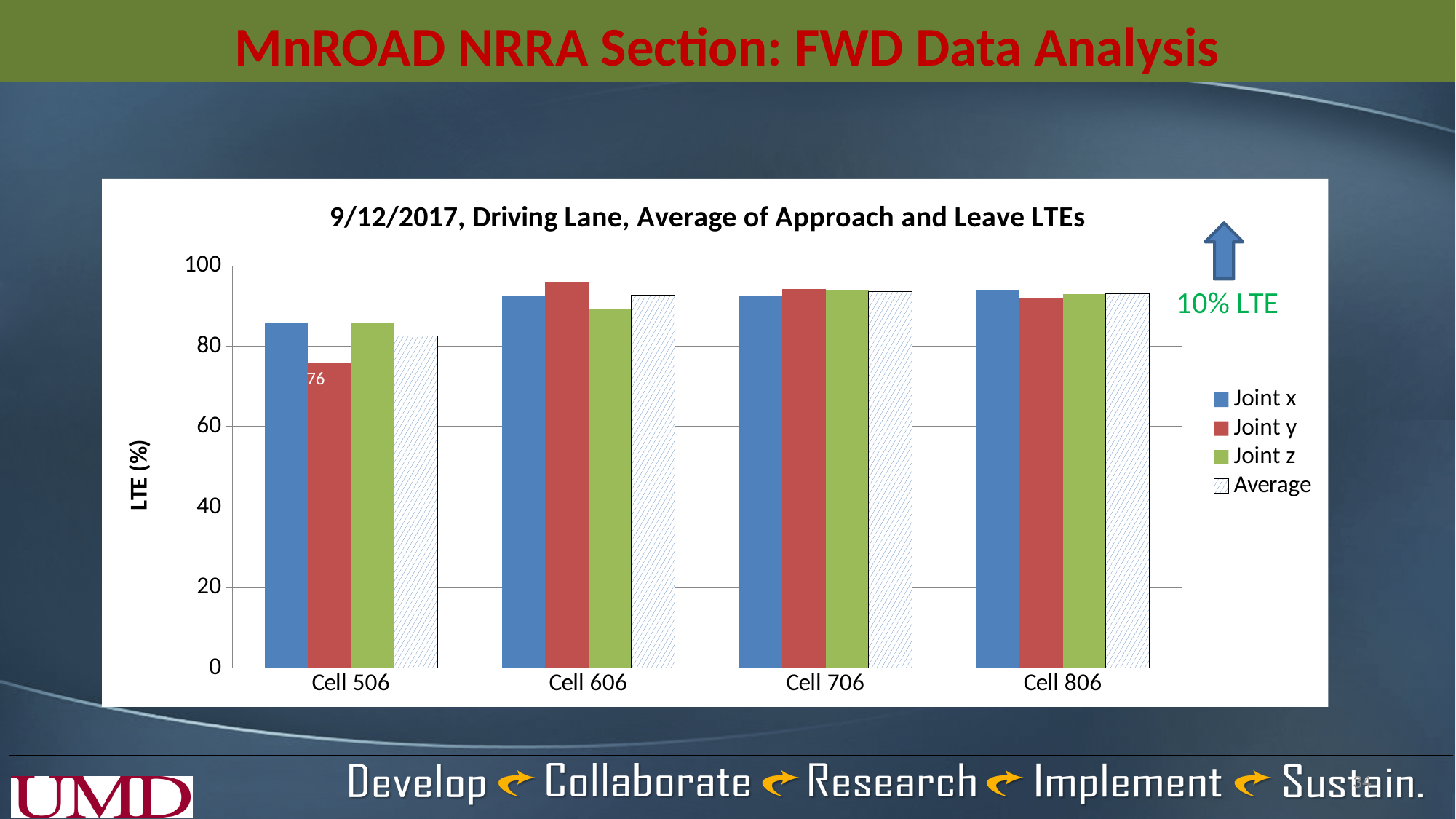
What is the LTE (%) value for Joint y at Cell 506? 76 Is the value for Joint y at Cell 506 greater or less than 80? less Which is larger: the Joint z value at Cell 606 or the Joint z value at Cell 706? Cell 706 Which is larger: the Joint y value at Cell 506 or the Joint y value at Cell 606? Cell 606 Is the value for Joint x at Cell 606 greater or less than 80? greater Is the Average value for Cell 506 greater or less than 80? greater What kind of chart is shown on the slide? Bar chart Which cell has the lowest Joint y value? Cell 506 What is the title of the chart? 9/12/2017, Driving Lane, Average of Approach and Leave LTEs How many cells (categories) are shown on the x axis? 4 How many series does the legend list? 4 Within Cell 506, which series has the lowest bar? Joint y